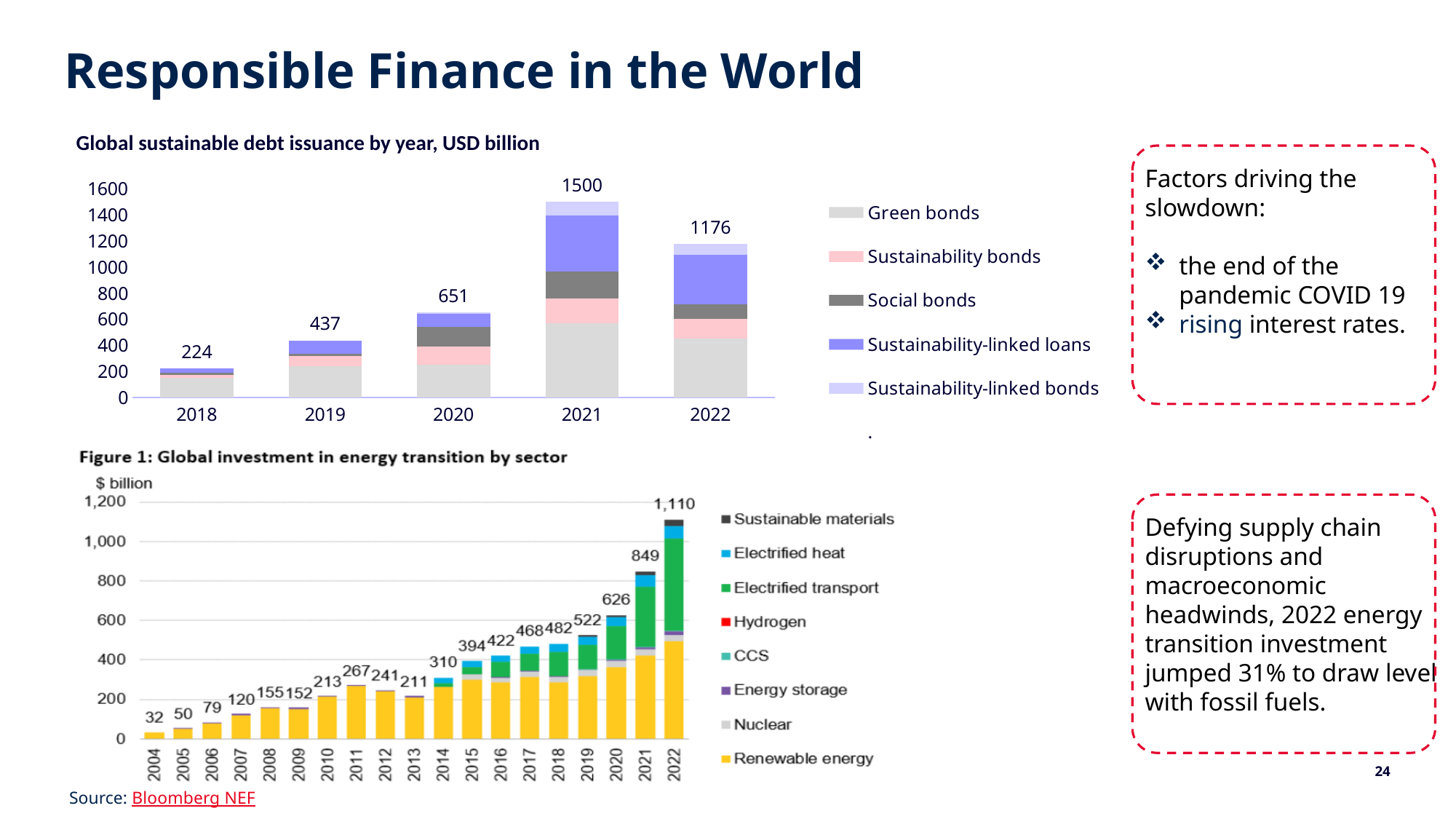
In the 'Global sustainable debt issuance by year, USD billion' chart, which year has the highest total issuance? 2021 In the 'Global sustainable debt issuance by year, USD billion' chart, which year has the lowest total issuance? 2018 In the 'Global sustainable debt issuance by year, USD billion' chart, which series is shown in light grey? Green bonds What kind of chart is 'Figure 1: Global investment in energy transition by sector'? Stacked bar chart In the 'Global sustainable debt issuance by year, USD billion' chart, how many series does the legend list? 5 In the 'Global sustainable debt issuance by year, USD billion' chart, what is the total issuance for 2021? 1500 In the 'Global sustainable debt issuance by year, USD billion' chart, how many years are shown on the x axis? 5 In the 'Figure 1: Global investment in energy transition by sector' chart, what is the total investment for 2004? 32 In the 'Figure 1: Global investment in energy transition by sector' chart, how many series does the legend list? 8 In the 'Global sustainable debt issuance by year, USD billion' chart, what is the difference between the 2021 total and the 2022 total? 324 In the 'Figure 1: Global investment in energy transition by sector' chart, what is the total investment for 2022? 1,110 In the 'Figure 1: Global investment in energy transition by sector' chart, what is the difference between the 2022 total and the 2021 total? 261